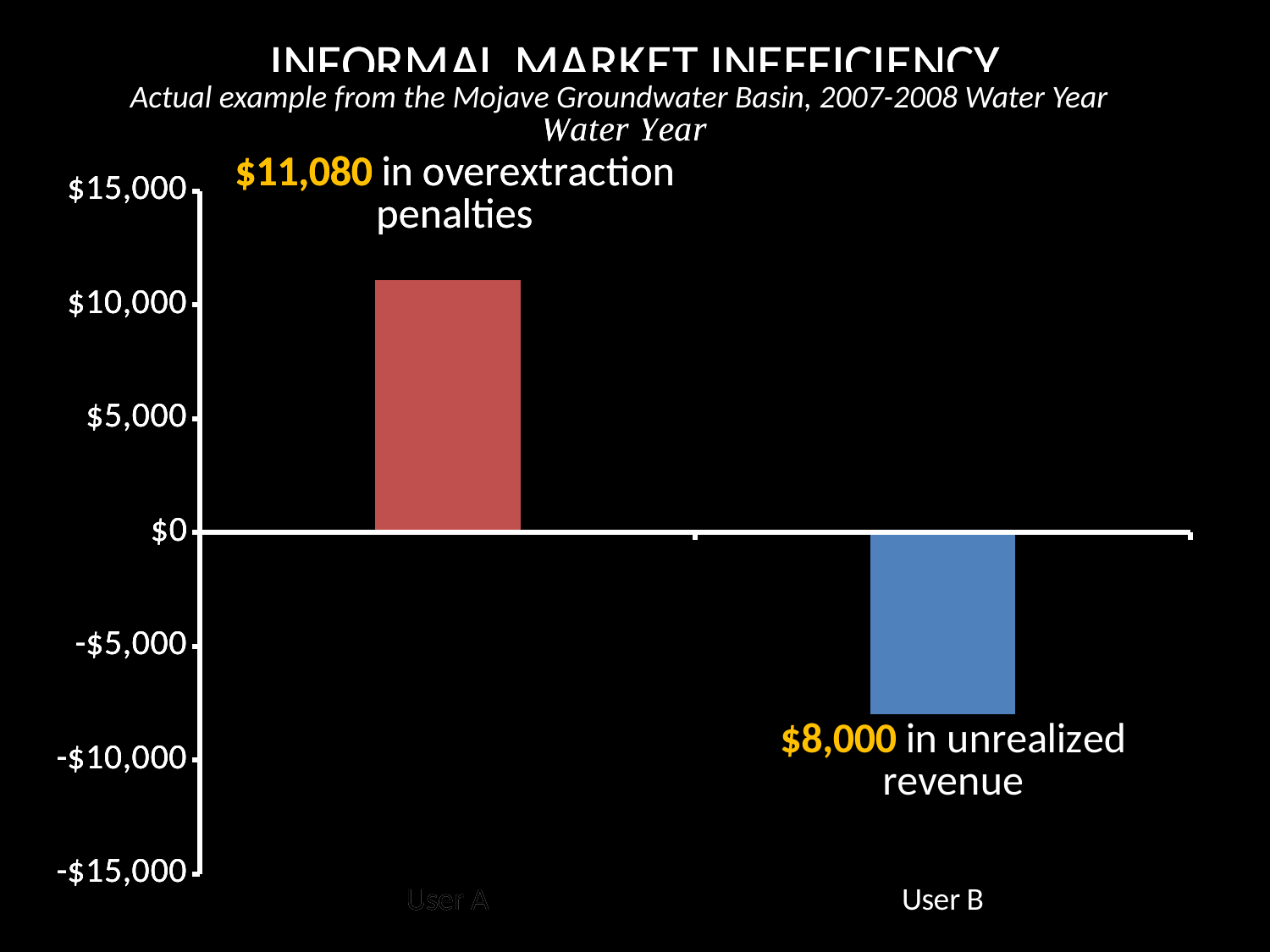
What amount in unrealized revenue is shown for User B? $8,000 Which category has the lowest bar on the chart? User B What kind of chart is shown on the slide? bar chart What is the lowest value shown on the vertical axis? -$15,000 Is the value for User A greater or less than $10,000? greater How many categories are plotted on the chart? 2 Is the value for User B greater or less than $0? less What colour is the bar for User B? blue Which bar is larger in value, User A or User B? User A Which category has the highest bar on the chart? User A How much larger is User A's overextraction penalty ($11,080) than User B's unrealized revenue ($8,000)? $3,080 What amount in overextraction penalties is shown for User A? $11,080